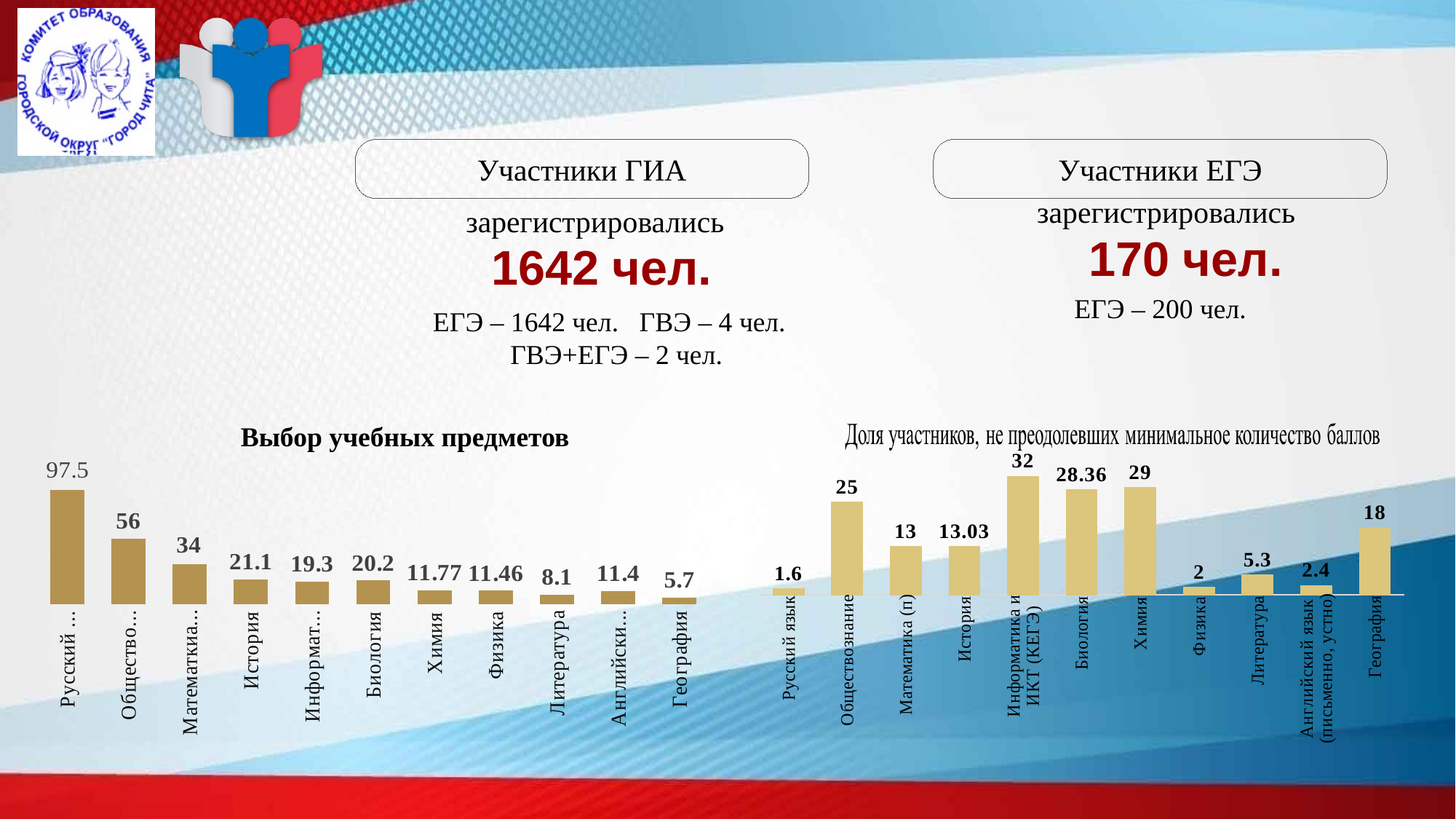
How many categories are shown in the chart 'Выбор учебных предметов'? 11 In the chart 'Выбор учебных предметов', what is the difference between the values for Химия and Физика? 0.31 In the chart 'Выбор учебных предметов', what is the value for Биология? 20.2 In the chart 'Доля участников, не преодолевших минимальное количество баллов', what is the value for Биология? 28.36 In the chart 'Доля участников, не преодолевших минимальное количество баллов', what is the difference between the values for Химия and Обществознание? 4 In the chart 'Выбор учебных предметов', which is larger: the value for Литература or the value for География? Литература In the chart 'Доля участников, не преодолевших минимальное количество баллов', which is larger: the value for География or the value for Математика (п)? География In the chart 'Доля участников, не преодолевших минимальное количество баллов', which category has the highest value? Информатика и ИКТ (КЕГЭ) In the chart 'Доля участников, не преодолевших минимальное количество баллов', which category has the lowest value? Русский язык In the chart 'Выбор учебных предметов', what is the value for История? 21.1 In the chart 'Выбор учебных предметов', which category has the lowest value? География What type of chart is 'Доля участников, не преодолевших минимальное количество баллов'? Bar chart